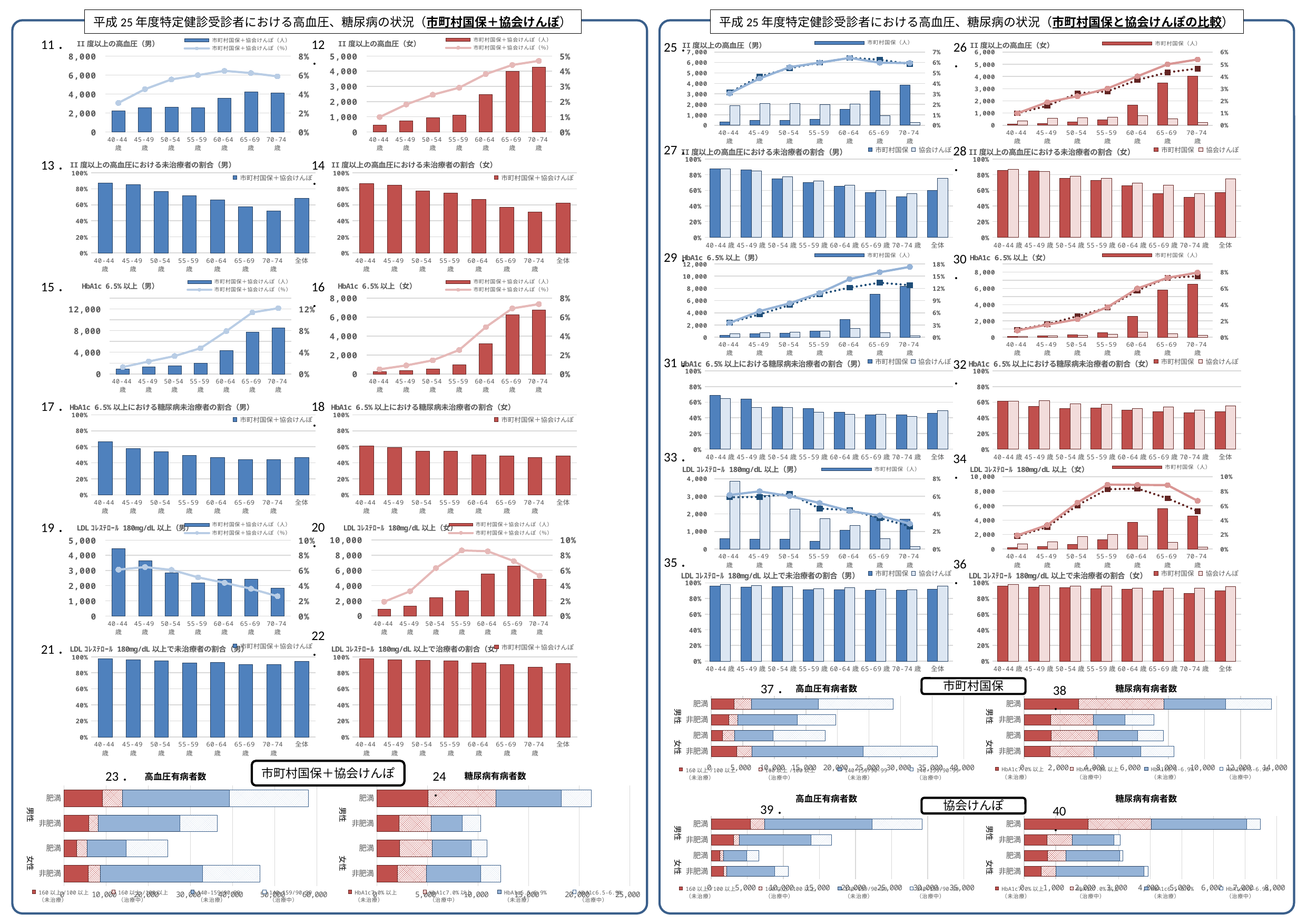
In chart 19 (LDLコレステロール 180mg/dL以上（男）), which is larger, the bar for 45-49歳 or the bar for 70-74歳? 45-49歳 In chart 12 (II度以上の高血圧（女）), which age group has the highest bar? 70-74歳 What kind of chart is chart 23 (高血圧有病者数)? stacked bar chart In chart 15 (HbA1c 6.5%以上（男）), is the bar for 70-74歳 greater or less than 8,000? greater In chart 13 (II度以上の高血圧における未治療者の割合（男）), which age group has the highest percentage? 40-44歳 In chart 19 (LDLコレステロール 180mg/dL以上（男）), which age group has the highest bar? 40-44歳 In chart 12 (II度以上の高血圧（女）), do the bar values generally rise or fall from 40-44歳 to 70-74歳? rise In chart 11 (II度以上の高血圧（男）), which age group has the lowest bar? 40-44歳 In chart 13 (II度以上の高血圧における未治療者の割合（男）), how many categories are shown on the x axis? 8 In chart 27 (II度以上の高血圧における未治療者の割合（男）), how many series does the legend list? 2 In chart 20 (LDLコレステロール 180mg/dL以上（女）), which age group has the lowest bar? 40-44歳